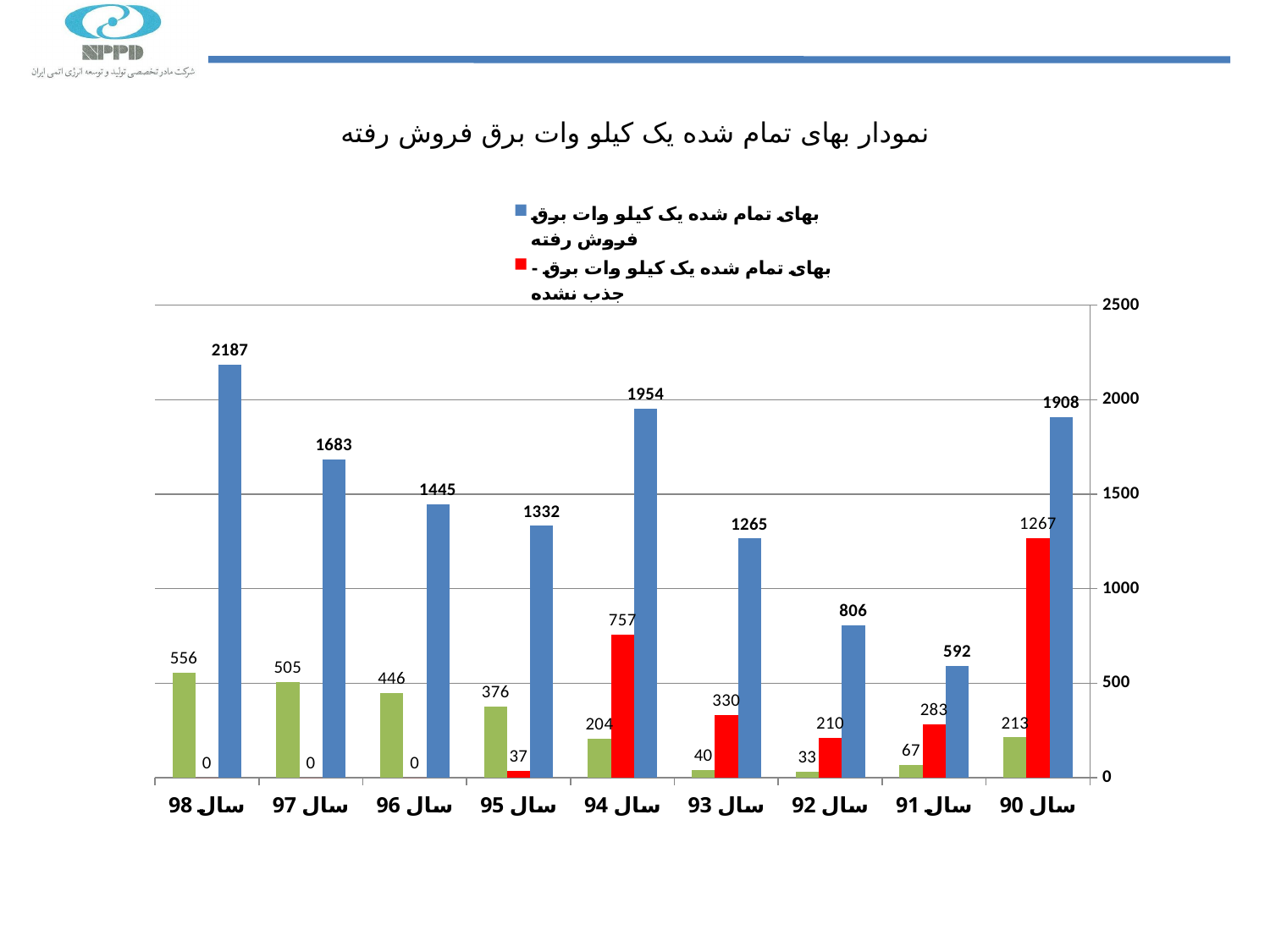
Which year has the lowest blue bar (فروش رفته)? سال 91 Is the blue bar for سال 92 greater or less than 1000? less Which year has the highest red bar (جذب نشده)? سال 90 What kind of chart is shown on the slide? Bar chart What is the difference between the blue bar values for سال 98 and سال 97? 504 What colour is the series labelled 'بهای تمام شده یک کیلو وات برق - جذب نشده' in the legend? Red Which is larger: the blue bar for سال 94 or the blue bar for سال 90? سال 94 Which year has the highest blue bar (فروش رفته)? سال 98 How many years (categories) are shown on the x axis? 9 What is the value of the blue bar (بهای تمام شده یک کیلو وات برق فروش رفته) for سال 98? 2187 What is the value of the green bar for سال 96? 446 What is the value of the red bar (جذب نشده) for سال 94? 757